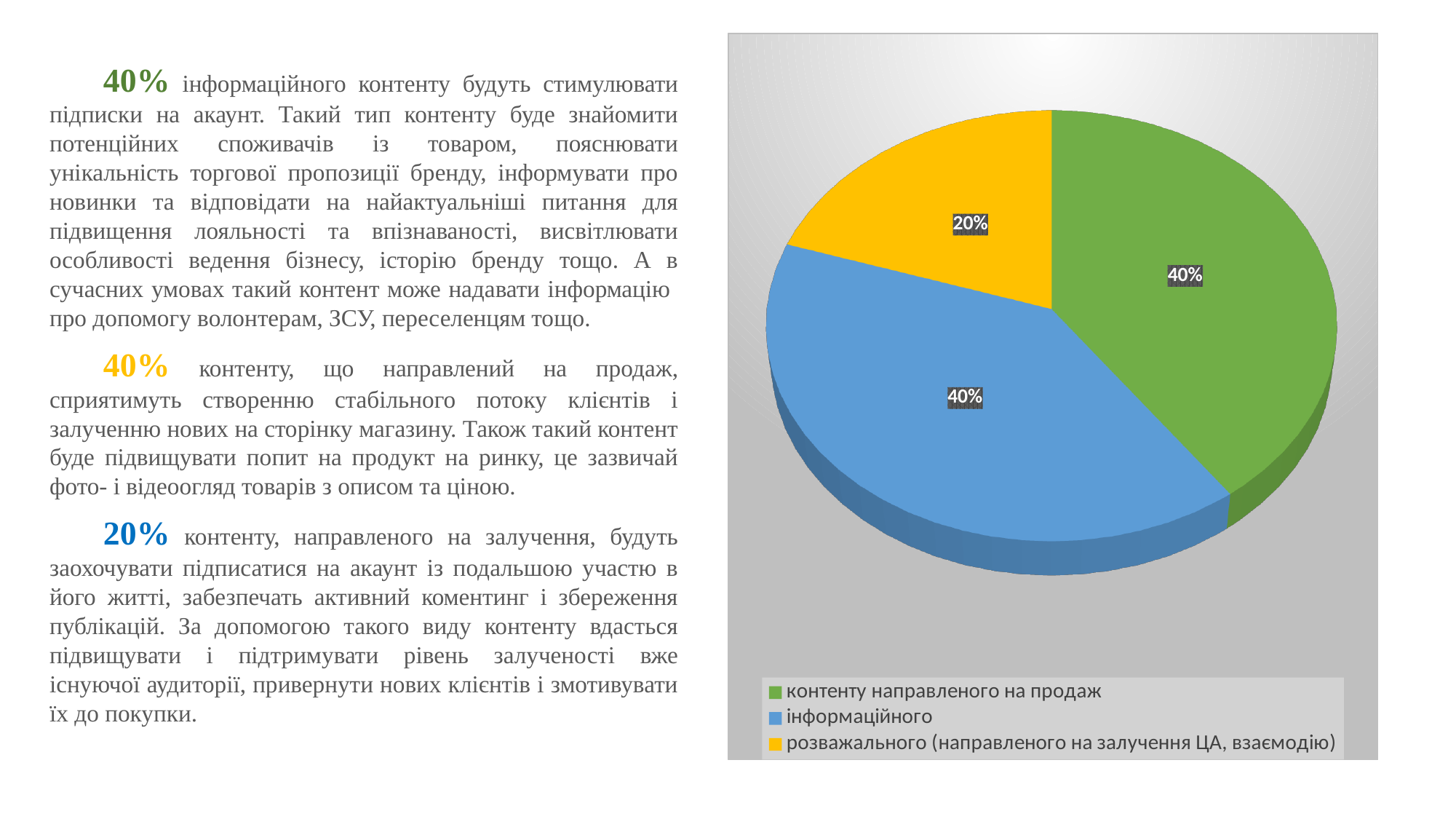
Which is larger: the slice for "контенту направленого на продаж" or the slice for "розважального (направленого на залучення ЦА, взаємодію)"? контенту направленого на продаж How many entries does the chart legend list? 3 By how many percentage points does the "інформаційного" slice exceed the "розважального" slice? 20 Which category is shown in green in the pie chart? контенту направленого на продаж What percentage does the "інформаційного" slice show? 40% What percentage of the pie chart is labelled for "контенту направленого на продаж"? 40% Which category has the smallest slice of the pie chart? розважального (направленого на залучення ЦА, взаємодію) What kind of chart is shown on the slide? pie chart What percentage is shown for "розважального (направленого на залучення ЦА, взаємодію)"? 20% What share of the pie does the yellow slice represent? 20% What colour is the slice for "інформаційного" in the pie chart? blue How many slices does the pie chart have? 3